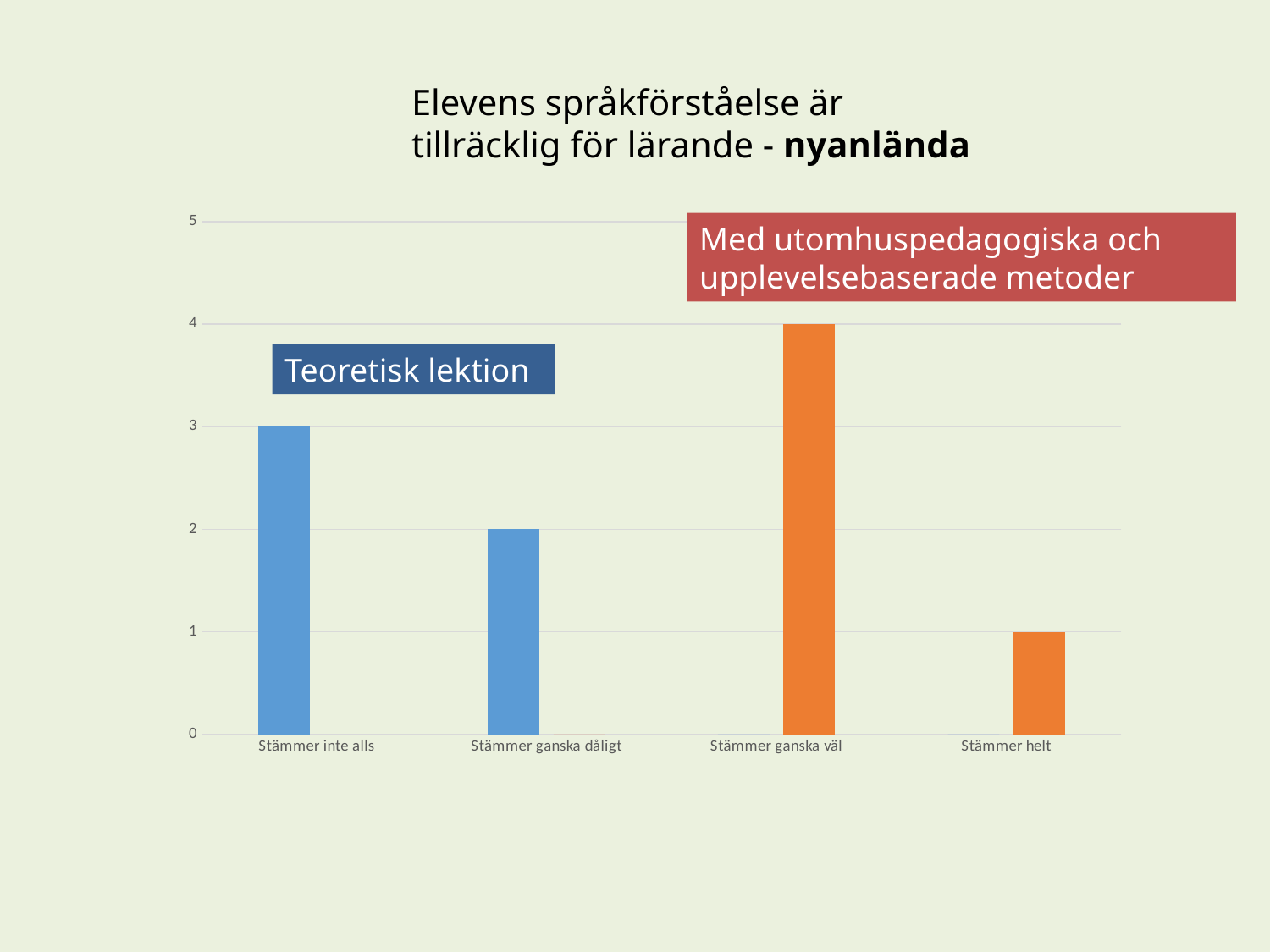
How many categories are shown on the x axis of the chart? 4 Which label is shown in the blue box above the blue bars? Teoretisk lektion What is the value for "Stämmer helt"? 1 What is the title of the chart? Elevens språkförståelse är tillräcklig för lärande - nyanlända What kind of chart is shown on the slide? bar chart What is the difference between the values for "Stämmer ganska väl" and "Stämmer helt"? 3 What is the value for "Stämmer inte alls"? 3 What is the value for "Stämmer ganska dåligt"? 2 Which category has the highest bar? Stämmer ganska väl Which is larger, the value for "Stämmer inte alls" or the value for "Stämmer ganska dåligt"? Stämmer inte alls Which category has the lowest bar? Stämmer helt What is the value for "Stämmer ganska väl"? 4